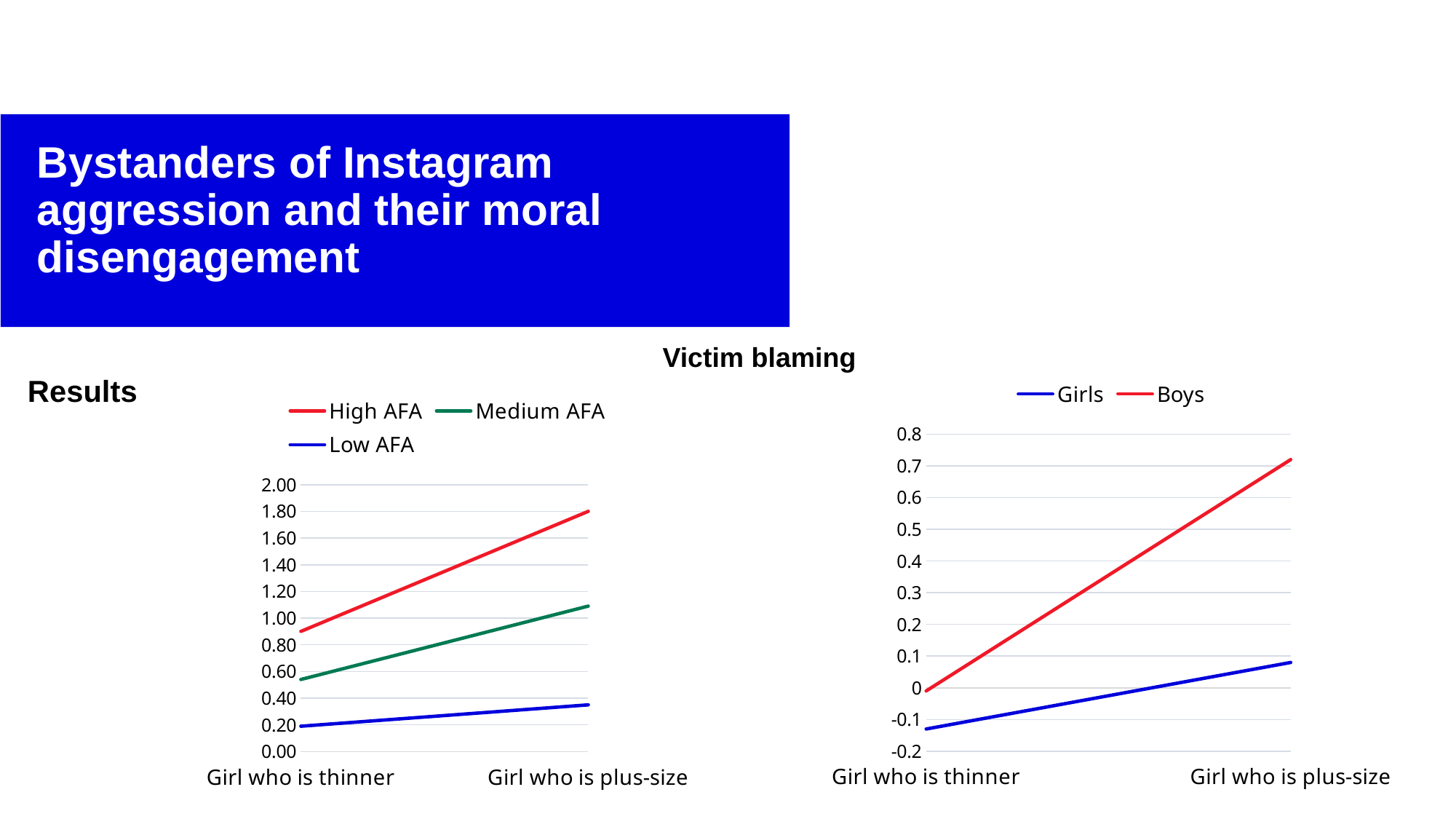
In the right chart, is the value for Boys at 'Girl who is plus-size' greater or less than 0.6? greater How many series does the legend of the right chart list? 2 In the left chart, which series has the highest value at 'Girl who is plus-size'? High AFA What kind of chart is the left chart (High AFA / Medium AFA / Low AFA)? line chart How many series does the legend of the left chart list? 3 What kind of chart is the right chart (Girls / Boys)? line chart In the right chart, is the value for Girls at 'Girl who is thinner' greater or less than 0? less In the right chart, does the Boys line rise or fall from 'Girl who is thinner' to 'Girl who is plus-size'? rise How many categories are on the x axis of the left chart? 2 In the left chart, is the value for Medium AFA at 'Girl who is plus-size' greater or less than 1.00? greater In the left chart, does the High AFA line rise or fall from 'Girl who is thinner' to 'Girl who is plus-size'? rise